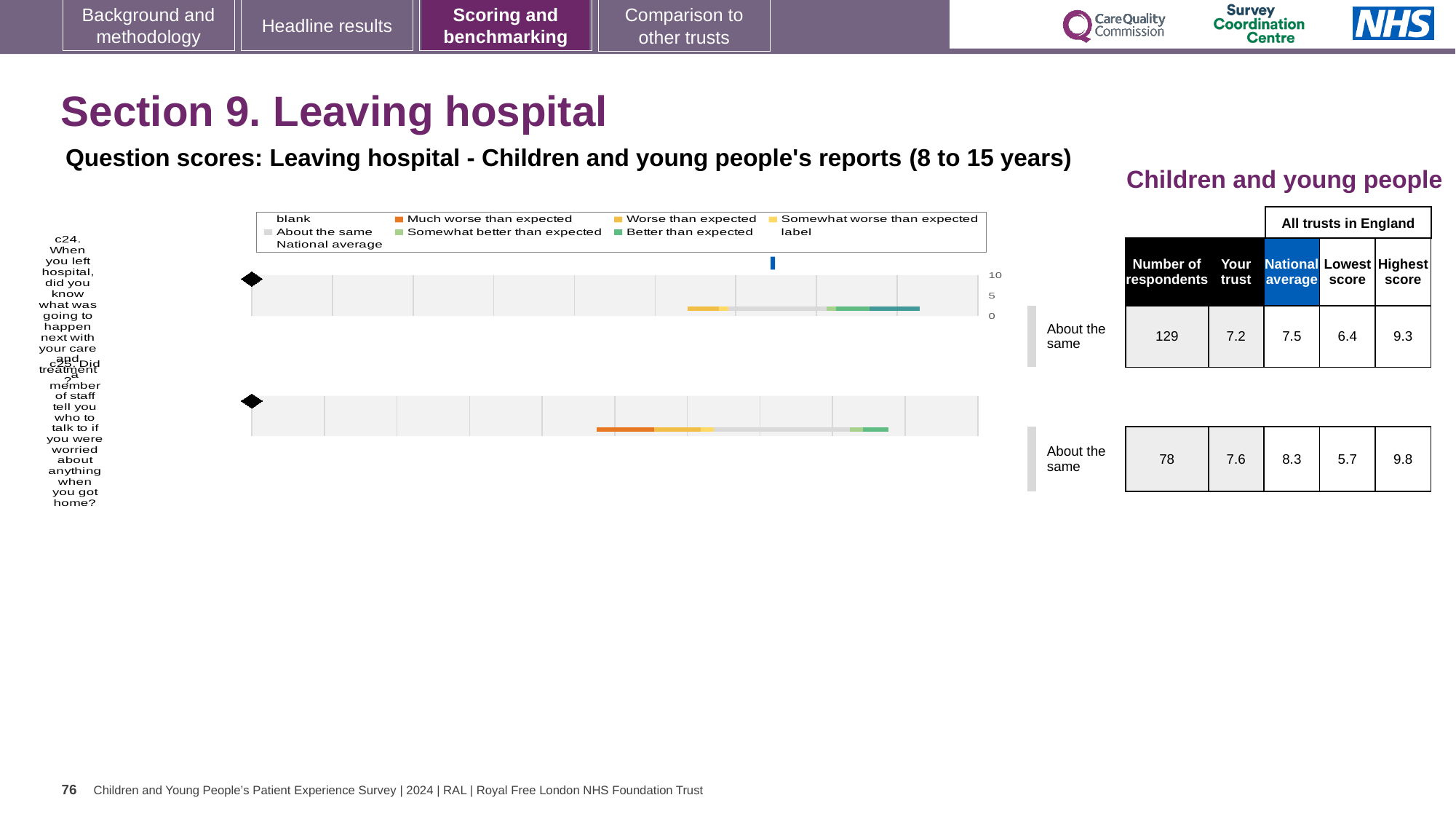
What colour represents 'Much worse than expected' in the legend? Orange What is the lowest score among all trusts in England for question c25? 5.7 What is the difference between the national average and the 'Your trust' score for question c25? 0.7 What is the highest score among all trusts in England for question c24? 9.3 What kind of chart is used to show the question scores for c24 and c25? bar chart What is the 'Your trust' score for question c24? 7.2 What is the national average score for question c25? 8.3 For question c25, which is larger: the 'Your trust' score or the national average? National average What benchmark category label is shown next to both question c24 and question c25? About the same What is the number of respondents for question c24? 129 How many questions are plotted in the chart? 2 What is the difference between the highest score and the lowest score for question c24? 2.9